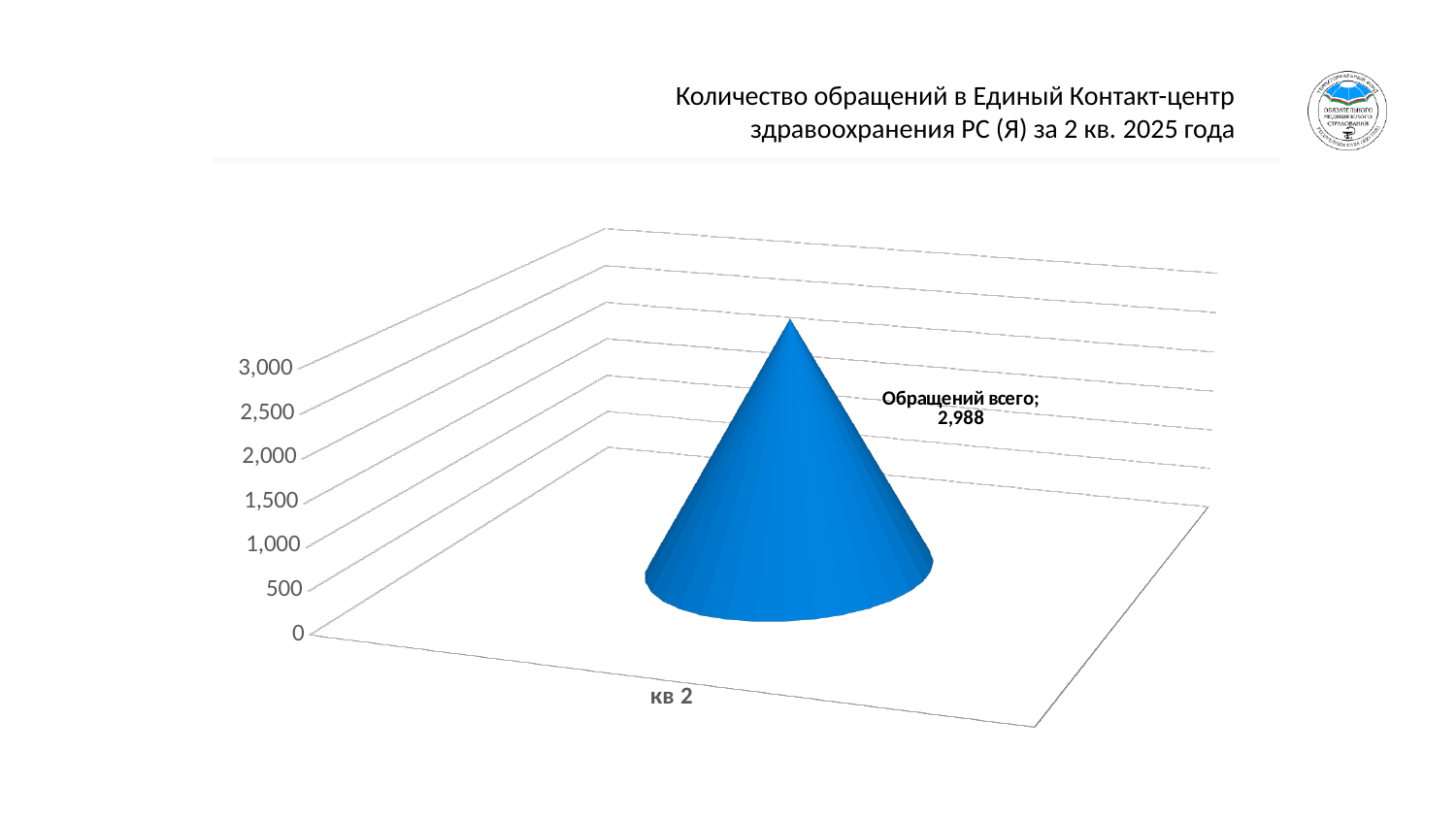
What is the value of the cone for the category "кв 2"? 2,988 What is the name of the data series shown in the chart's data label? Обращений всего What is the title of the chart on the slide? Количество обращений в Единый Контакт-центр здравоохранения РС (Я) за 2 кв. 2025 года What kind of chart is shown on the slide? bar chart Is the value for "кв 2" greater or less than 2,500? greater Is the value for "Обращений всего" greater or less than 1,000? greater How many categories are plotted on the x axis of the chart? 1 What is the value shown for "Обращений всего" in the chart? 2,988 Is the value for "кв 2" greater or less than 3,000? less